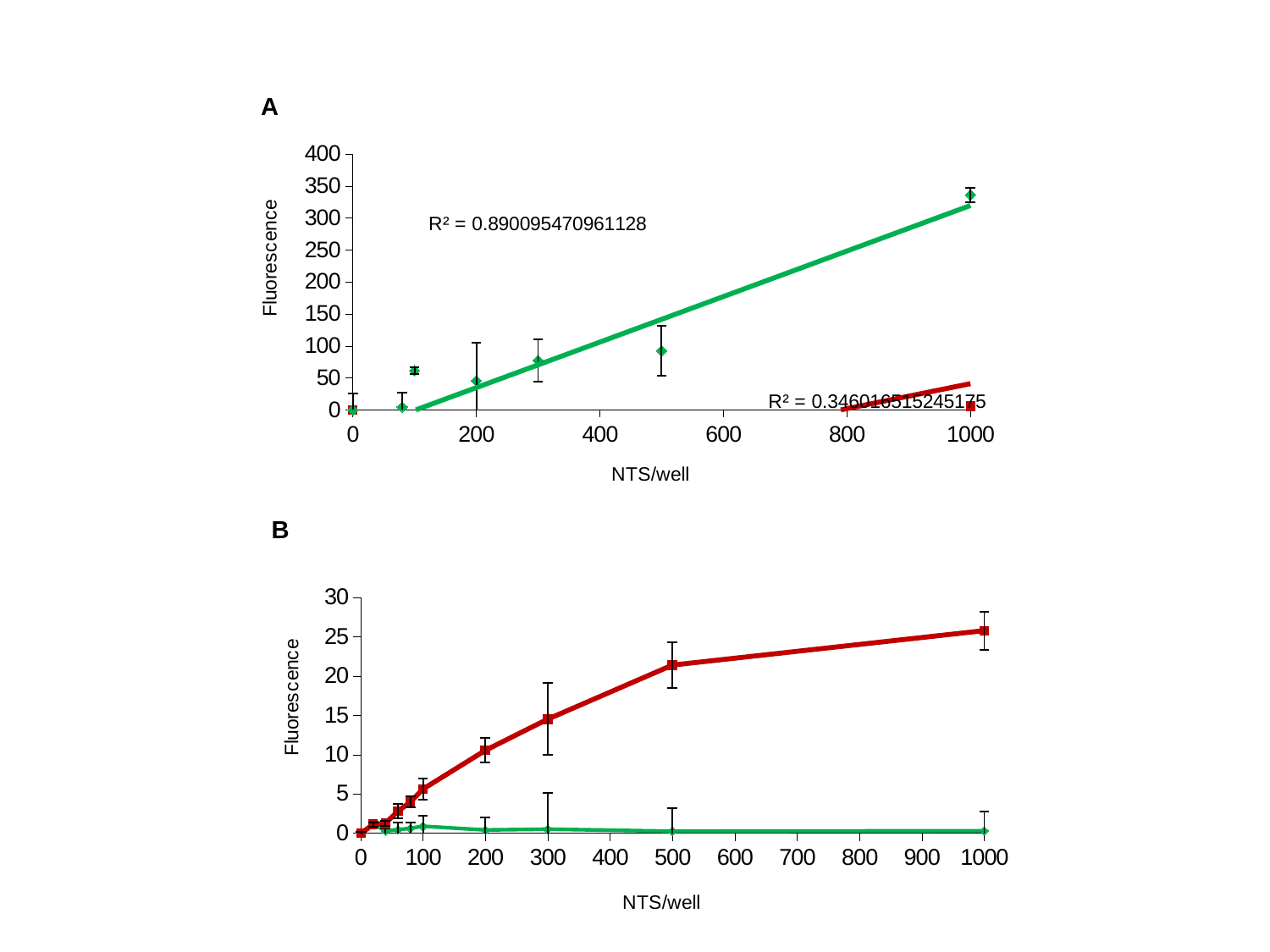
What kind of chart is chart B (the bottom chart)? line chart In chart B, at 1000 NTS/well, which series has the higher fluorescence, the red or the green? red In chart B, is the fluorescence of the red series at 500 NTS/well greater or less than 20? greater In chart A, does the green series rise or fall as NTS/well increases? rise In chart A, at 1000 NTS/well, which series has the higher fluorescence, the green or the red? green In chart A, what is the R² value printed for the green trendline? R² = 0.890095470961128 In chart A, what is the R² value printed for the red trendline? R² = 0.346016515245175 In chart B, is the fluorescence of the green series at 1000 NTS/well greater or less than 5? less What kind of chart is chart A (the top chart)? scatter chart with trendlines In chart A, is the fluorescence of the green series at 300 NTS/well greater or less than 100? less In chart B, does the red series rise or fall as NTS/well increases? rise